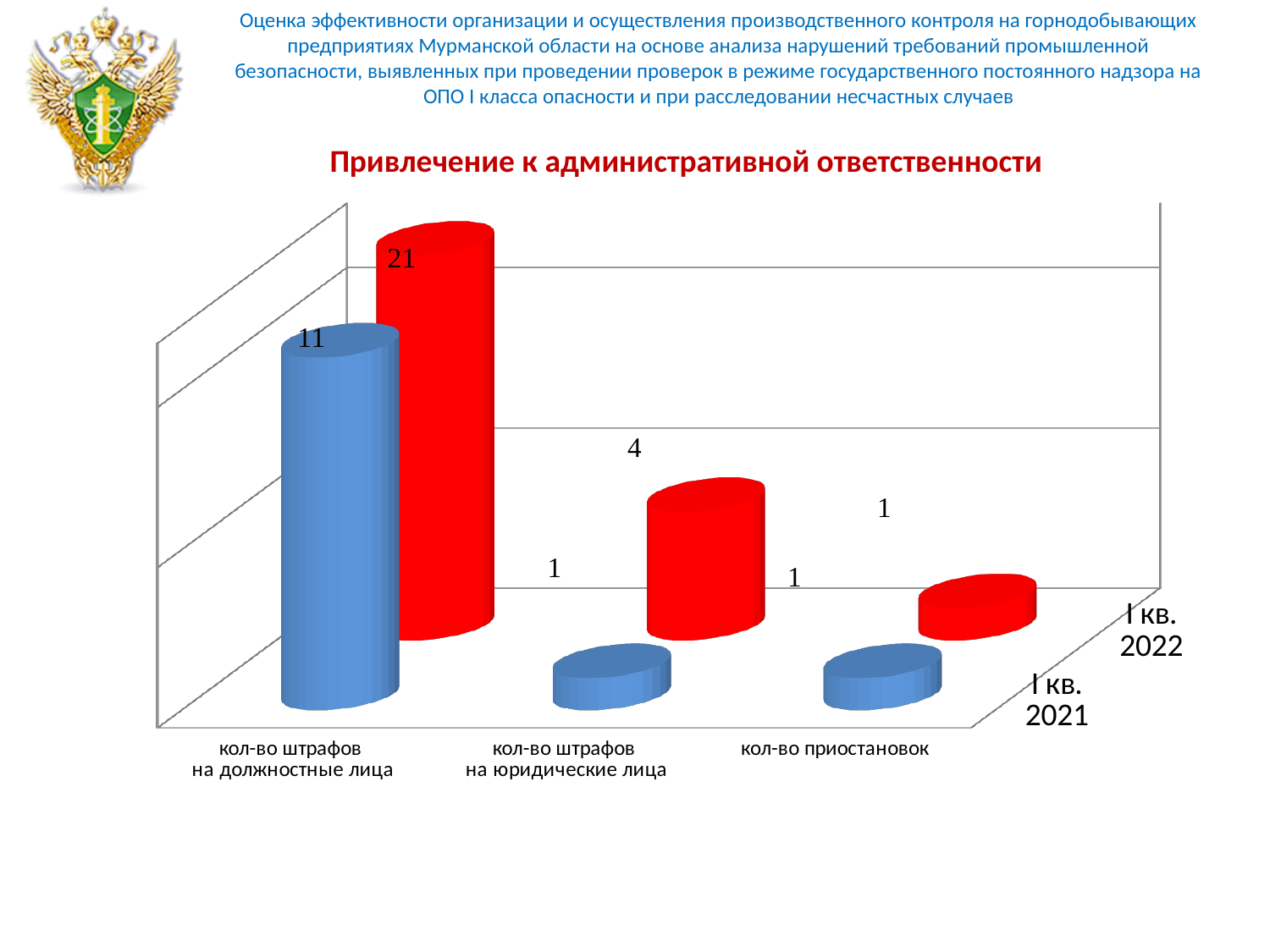
What is the value for 'кол-во приостановок' in I кв. 2022? 1 What is the value for 'кол-во штрафов на юридические лица' in I кв. 2022? 4 What is the difference between the I кв. 2022 and I кв. 2021 values for 'кол-во штрафов на должностные лица'? 10 How many data series (periods) does the chart show? 2 What is the difference between the I кв. 2022 and I кв. 2021 values for 'кол-во штрафов на юридические лица'? 3 What is the value for 'кол-во штрафов на юридические лица' in I кв. 2021? 1 What is the value for 'кол-во штрафов на должностные лица' in I кв. 2022? 21 What is the title of the chart? Привлечение к административной ответственности How many categories are shown on the x axis of the chart? 3 What is the value for 'кол-во штрафов на должностные лица' in I кв. 2021? 11 Which category has the highest value in I кв. 2022? кол-во штрафов на должностные лица Which is larger: 'кол-во штрафов на должностные лица' in I кв. 2021 or 'кол-во штрафов на юридические лица' in I кв. 2022? кол-во штрафов на должностные лица in I кв. 2021